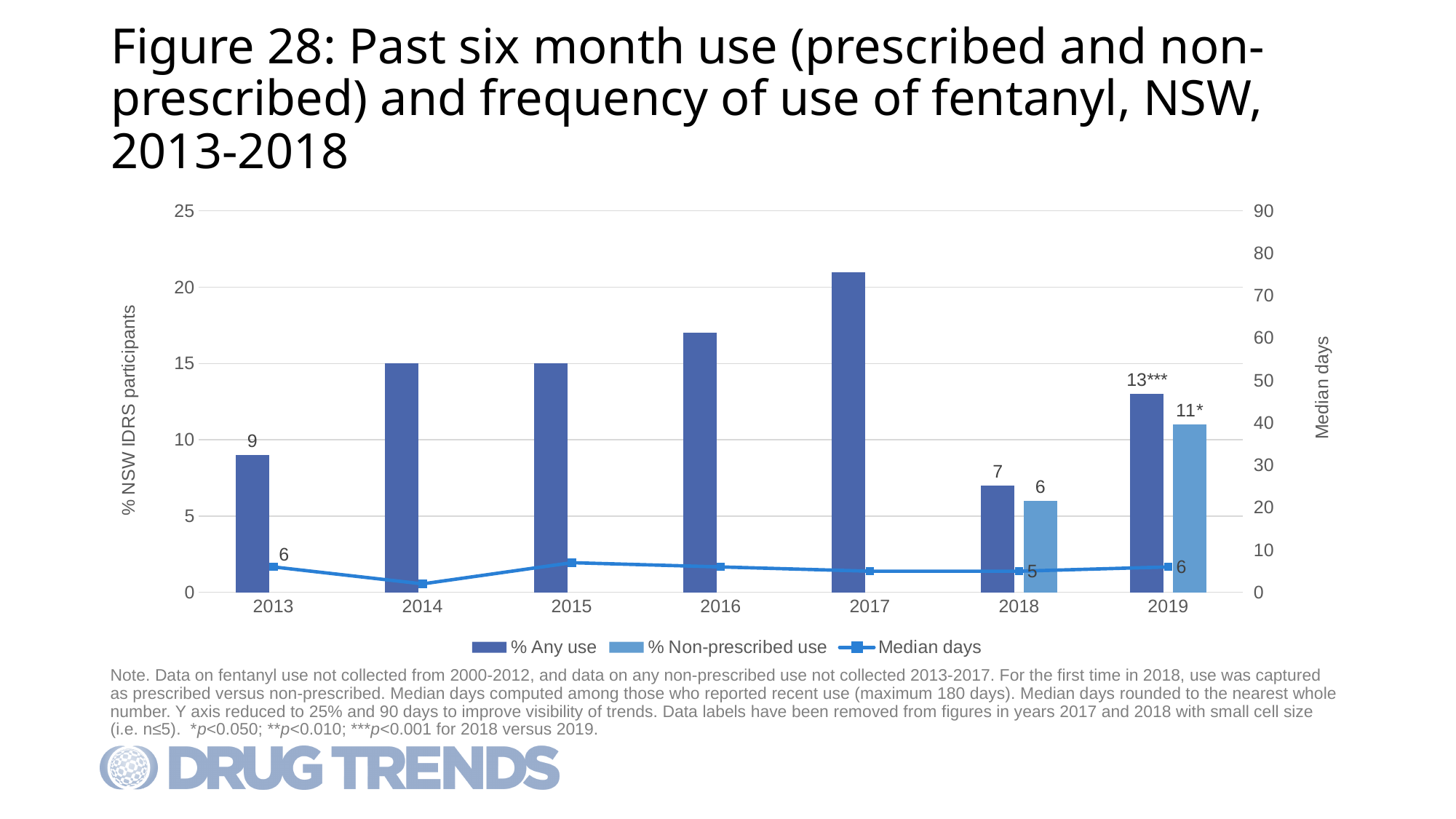
How many years are shown on the x axis? 7 Is the value for % Any use in 2017 greater or less than 20? greater How many series does the legend list? 3 What is the difference between % Any use and % Non-prescribed use in 2019? 2 What kind of chart is this? Bar and line chart Which year has the lowest % Any use bar? 2018 What is the value for % Any use in 2018? 7 What is the value for % Any use in 2013? 9 What is the Median days value in 2018? 5 Which year has the highest % Any use bar? 2017 What is the value for % Non-prescribed use in 2019? 11* Which is larger, % Any use in 2018 or % Any use in 2019? 2019